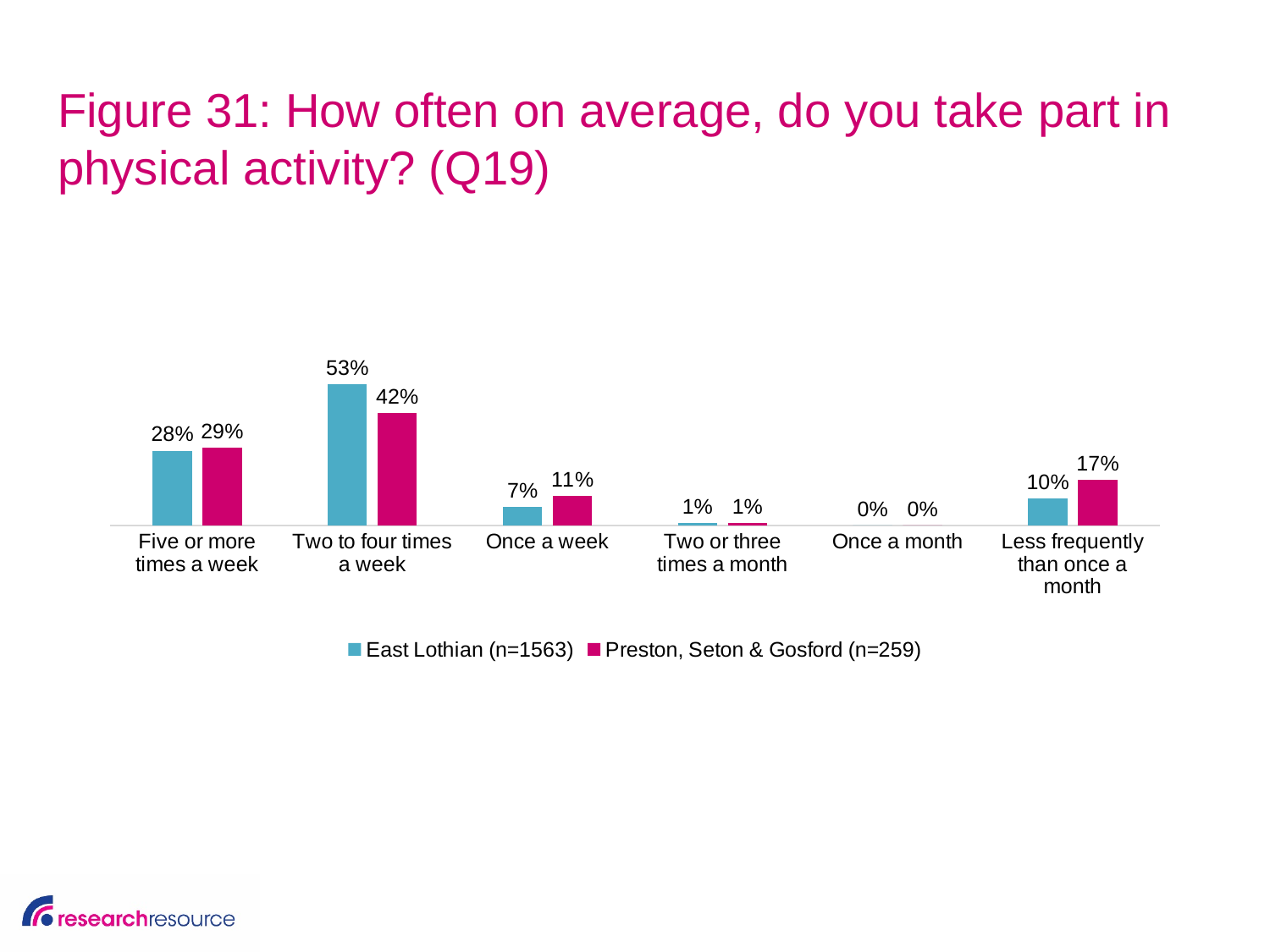
What is the value for Preston, Seton & Gosford for 'Once a week'? 11% What percentage of Preston, Seton & Gosford respondents take part in physical activity less frequently than once a month? 17% What kind of chart is shown on the slide? Bar chart What is the sample size (n) for East Lothian shown in the legend? 1563 How many categories are shown on the x axis? 6 What colour are the bars for Preston, Seton & Gosford? Pink Which category has the highest value for East Lothian? Two to four times a week What is the difference between the East Lothian and Preston, Seton & Gosford values for 'Two to four times a week'? 11% For 'Less frequently than once a month', which series has the larger value: East Lothian or Preston, Seton & Gosford? Preston, Seton & Gosford Which category has the lowest value for Preston, Seton & Gosford? Once a month What percentage of East Lothian respondents take part in physical activity two to four times a week? 53% How many series does the legend list? 2